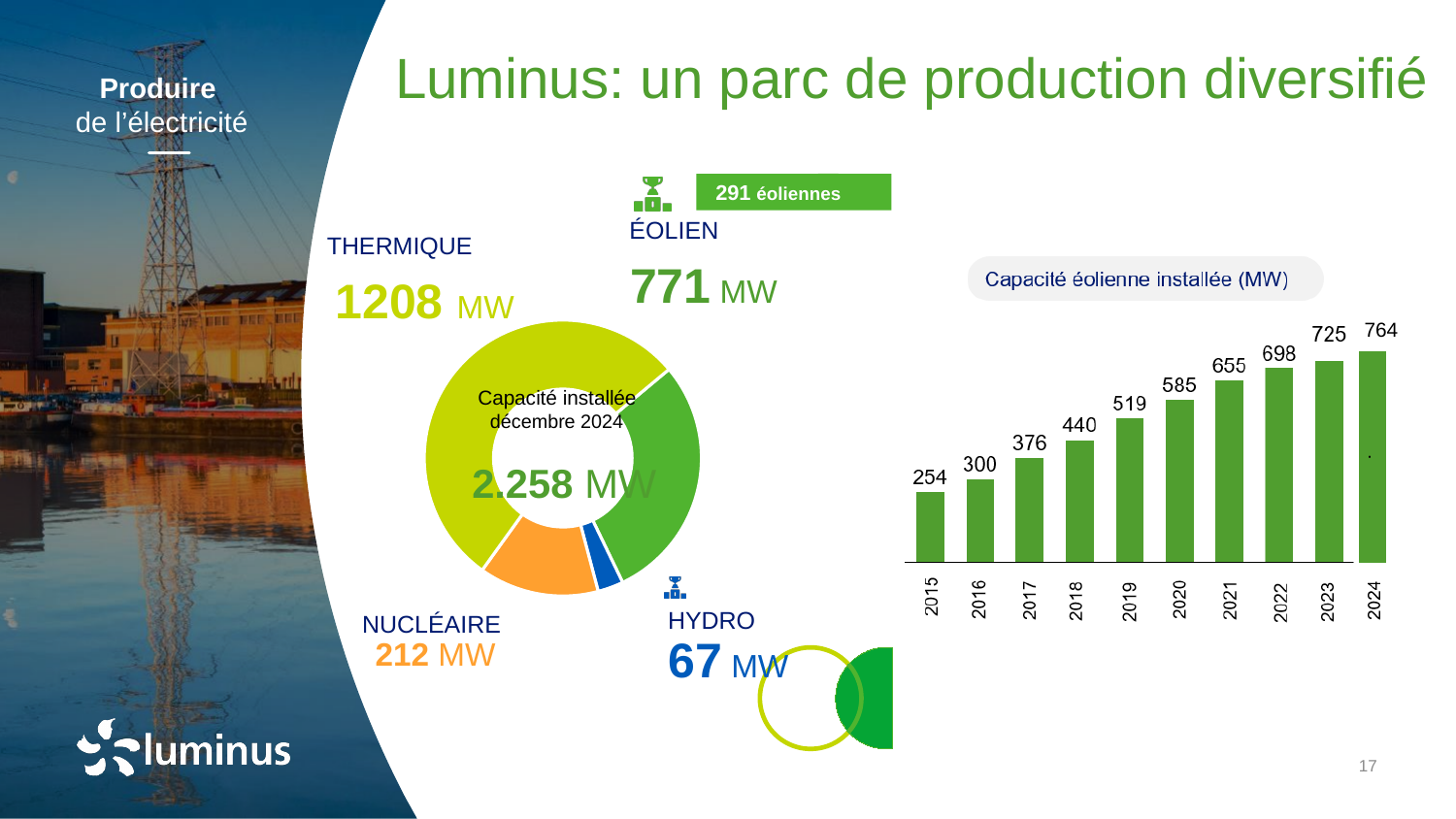
In the chart titled 'Capacité éolienne installée (MW)', which year has the highest value? 2024 What total is printed in the centre of the donut chart 'Capacité installée décembre 2024'? 2.258 MW In the chart titled 'Capacité éolienne installée (MW)', what is the value for 2019? 519 In the donut chart 'Capacité installée décembre 2024', which is larger, ÉOLIEN or NUCLÉAIRE? ÉOLIEN In the chart titled 'Capacité éolienne installée (MW)', how many years are shown on the x axis? 10 In the chart titled 'Capacité éolienne installée (MW)', what is the value for 2024? 764 In the donut chart 'Capacité installée décembre 2024', what is the value for THERMIQUE? 1208 MW In the chart titled 'Capacité éolienne installée (MW)', which year has the lowest value? 2015 In the chart titled 'Capacité éolienne installée (MW)', do the values rise or fall from 2015 to 2024? rise What kind of chart is the 'Capacité éolienne installée (MW)' chart? bar chart In the chart titled 'Capacité éolienne installée (MW)', what is the difference between the values for 2024 and 2015? 510 In the donut chart 'Capacité installée décembre 2024', which category has the smallest value? HYDRO